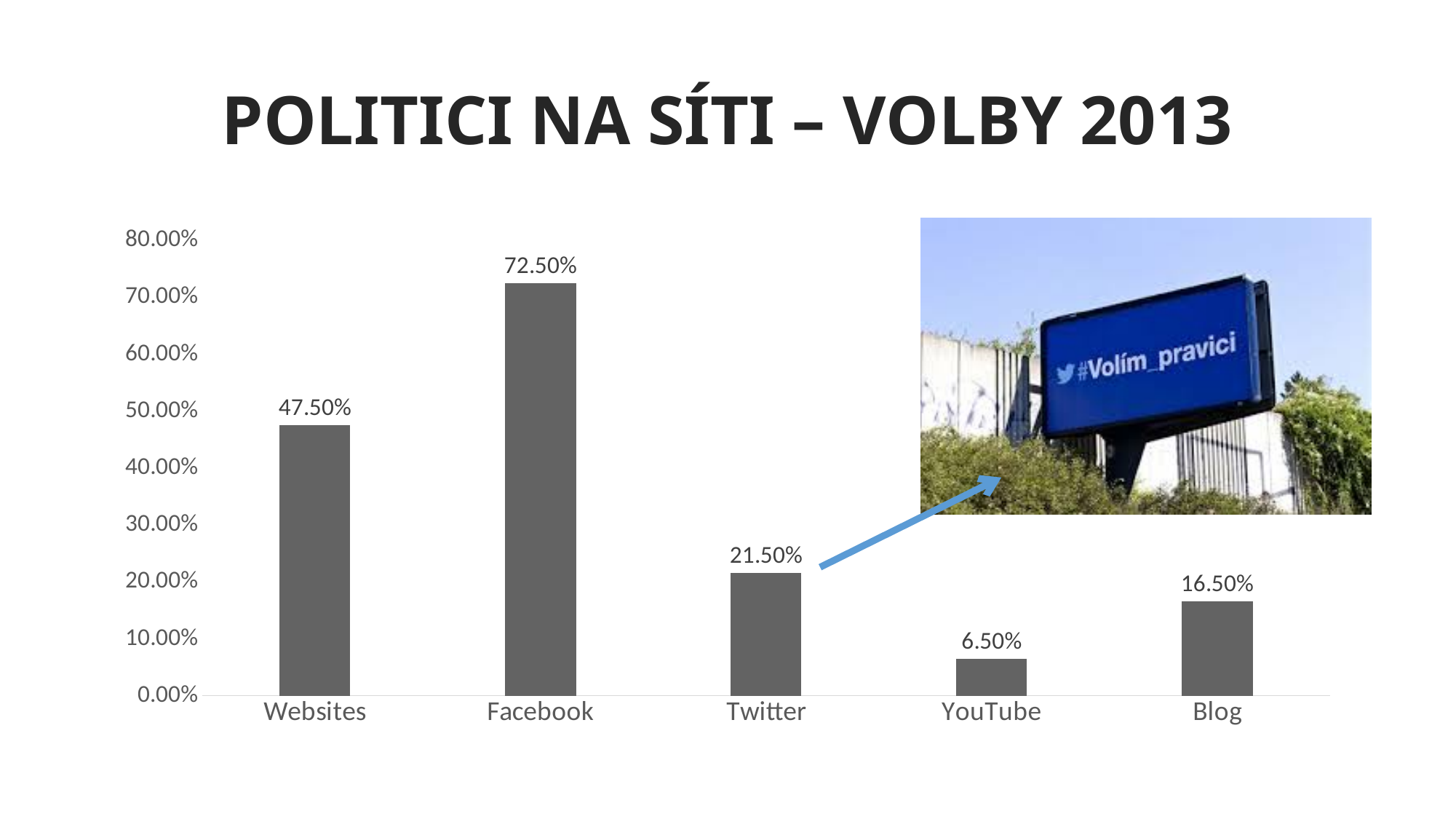
What is the value for YouTube? 6.50% What is the difference between the values for Twitter and Blog? 5.00% What is the value for Websites? 47.50% Which is larger, the value for Twitter or the value for Blog? Twitter What is the value for Facebook? 72.50% What kind of chart is shown on the slide? Bar chart What is the title of the slide containing the chart? POLITICI NA SÍTI – VOLBY 2013 What is the value for Blog? 16.50% What is the difference between the values for Facebook and Websites? 25.00% Which category has the lowest value? YouTube Which category has the highest value? Facebook How many categories are shown on the x axis? 5